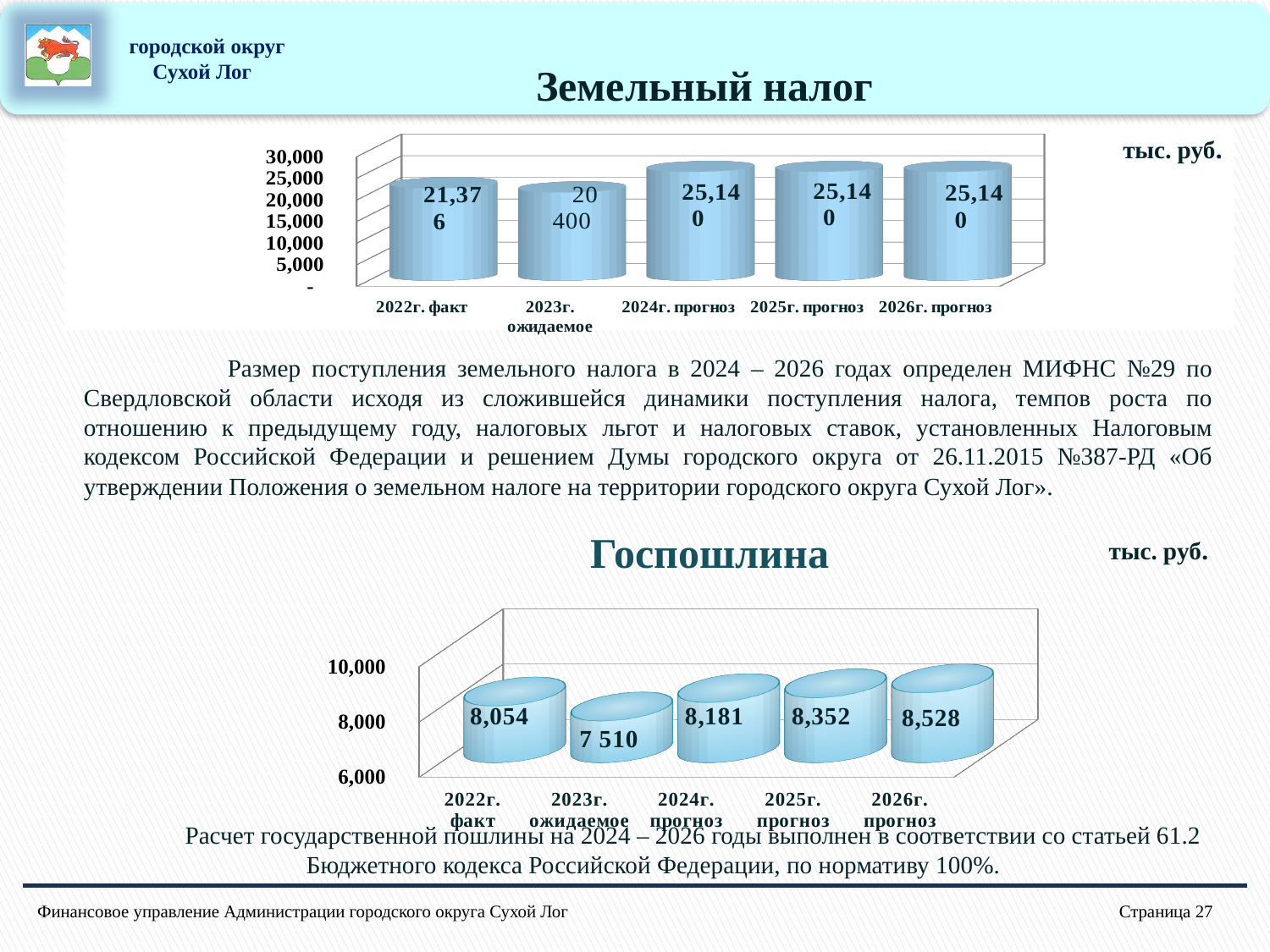
On the Госпошлина chart, what is the value for 2023г. ожидаемое? 7 510 On the Земельный налог chart, which category has the lowest value? 2023г. ожидаемое On the Госпошлина chart, which category has the highest value? 2026г. прогноз On the Земельный налог chart, is the value for 2023г. ожидаемое greater or less than 25,000? less On the Земельный налог chart, what is the value for 2022г. факт? 21,376 On the Госпошлина chart, what is the value for 2026г. прогноз? 8,528 What kind of chart is the Госпошлина chart? bar chart On the Земельный налог chart, how many categories are shown on the x axis? 5 On the Земельный налог chart, what is the value for 2025г. прогноз? 25,140 On the Земельный налог chart, what is the difference between the 2024г. прогноз value and the 2022г. факт value? 3,764 On the Госпошлина chart, which is larger: the value for 2022г. факт or the value for 2024г. прогноз? 2024г. прогноз On the Земельный налог chart, what is the value for 2023г. ожидаемое? 20 400